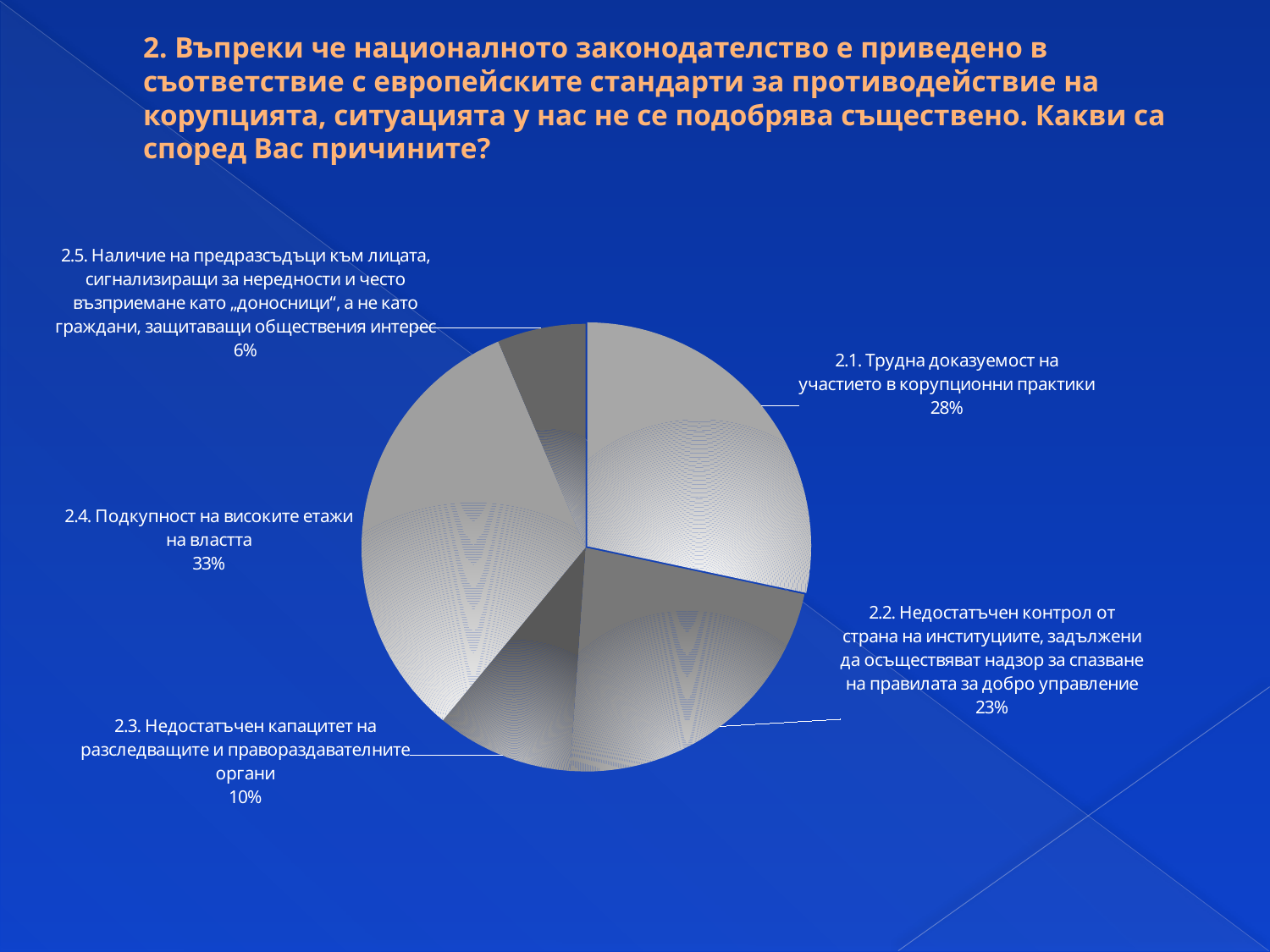
Which category has the largest share of the pie? 2.4. Подкупност на високите етажи на властта What is the combined share of 2.1 and 2.2? 51% What percentage is shown for 2.5 (Наличие на предразсъдъци към лицата, сигнализиращи за нередности)? 6% What percentage is shown for 2.3 (Недостатъчен капацитет на разследващите и правораздавателните органи)? 10% What percentage is shown for 2.4 (Подкупност на високите етажи на властта)? 33% What share of the pie is labelled for 2.1 (Трудна доказуемост на участието в корупционни практики)? 28% Which category has the smallest share of the pie? 2.5. Наличие на предразсъдъци към лицата, сигнализиращи за нередности What kind of chart is shown on the slide? pie chart Which has the larger share, 2.2 or 2.3? 2.2 What percentage is shown for 2.2 (Недостатъчен контрол от страна на институциите)? 23% How many slices does the pie chart have? 5 What is the difference in percentage points between the shares for 2.4 and 2.1? 5